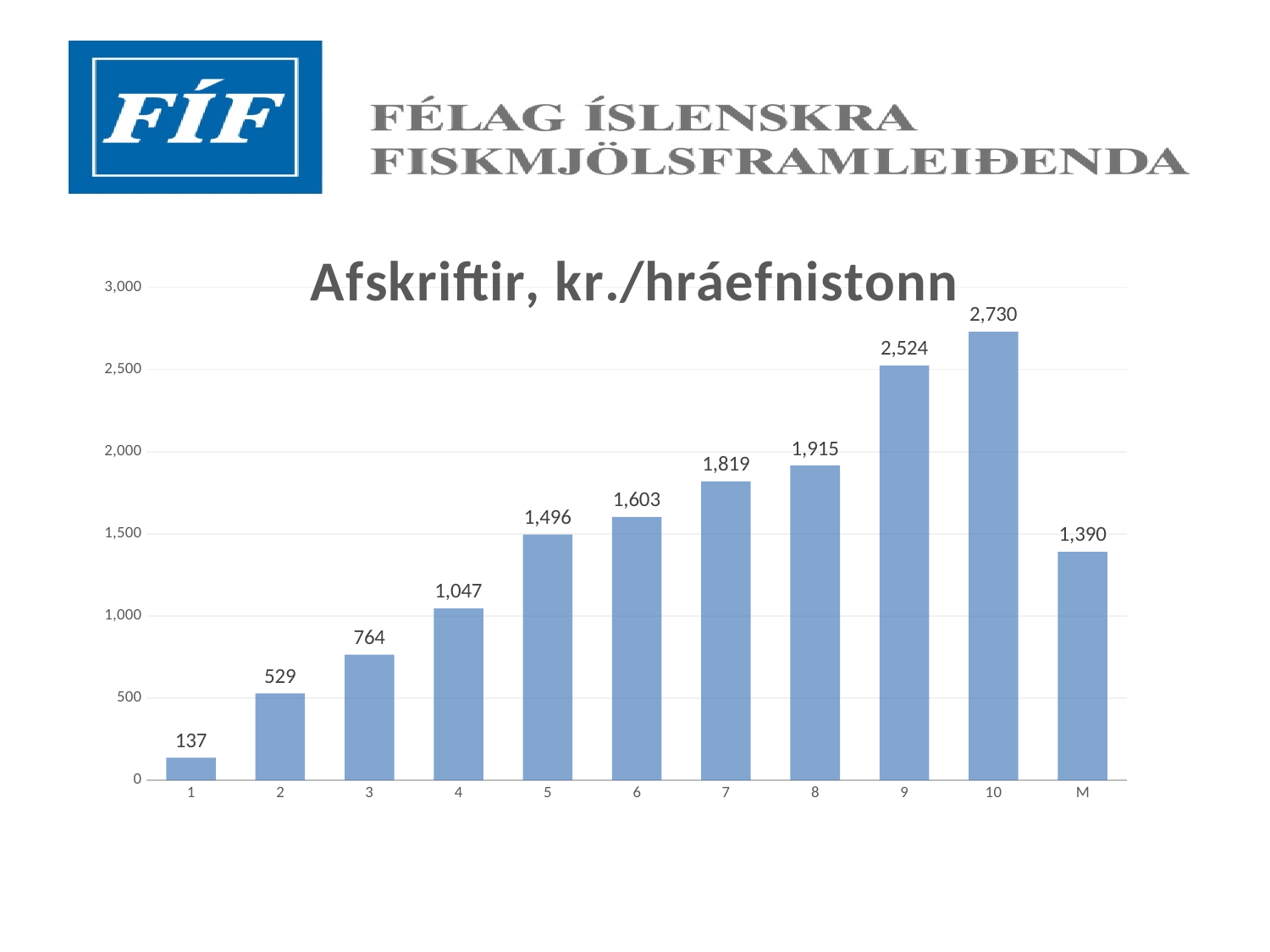
What is the value for category 7? 1,819 What is the title of the chart? Afskriftir, kr./hráefnistonn What kind of chart is shown on the slide? bar chart What is the value for category M? 1,390 What is the difference between the values for category 2 and category 1? 392 Is the value for category 8 greater or less than 2,000? less Which category has the highest value? 10 Which is larger, the value for category 6 or the value for category M? 6 Which category has the lowest value? 1 What is the difference between the values for category 10 and category 9? 206 How many bars are shown in the chart? 11 What is the value for category 4? 1,047